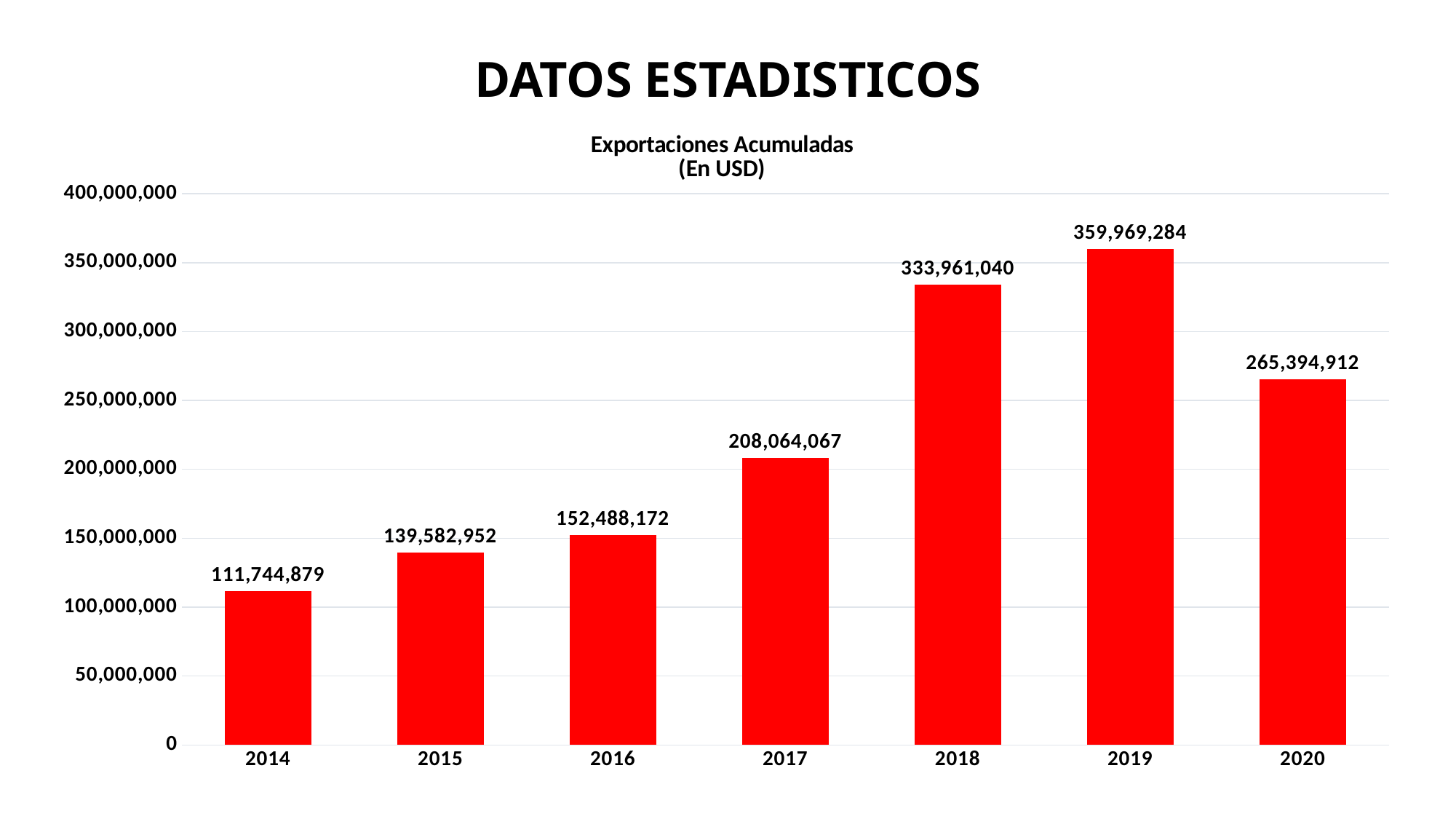
What is the title of the chart? Exportaciones Acumuladas (En USD) What kind of chart is this? bar chart What is the difference between the values for 2017 and 2016? 55,575,895 What is the value for 2017? 208,064,067 What is the difference between the values for 2019 and 2018? 26,008,244 How many years are shown on the x axis? 7 Which is larger, the value for 2018 or the value for 2020? 2018 What is the value for 2020? 265,394,912 Which year has the highest value? 2019 Which year has the lowest value? 2014 What is the value for 2014? 111,744,879 Is the value for 2016 greater or less than 200,000,000? less